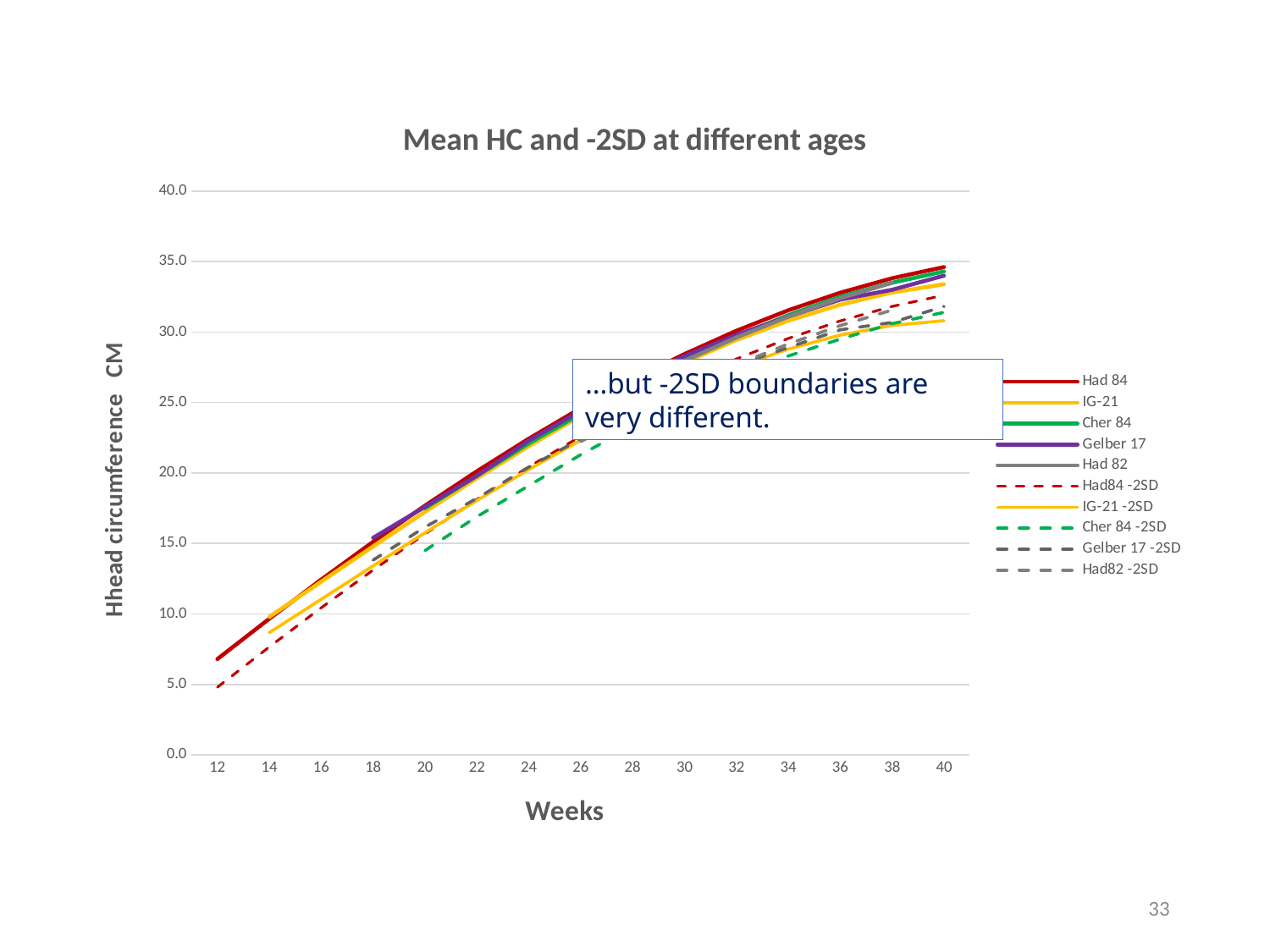
Is the value for IG-21 -2SD at week 40 greater or less than 35? less What kind of chart is shown on the slide? Line chart How many tick labels are shown on the x axis? 15 At week 40, which is larger, the Had 84 value or the IG-21 -2SD value? Had 84 Is the value for IG-21 at week 14 greater or less than 15? less What is the label of the x axis? Weeks Is the value for Had 84 at week 40 greater or less than 30? greater Do the Cher 84 -2SD values rise or fall as the weeks increase? Rise Do the Had 84 values rise or fall as the weeks increase? Rise How many series does the legend list? 10 What is the title of the chart? Mean HC and -2SD at different ages